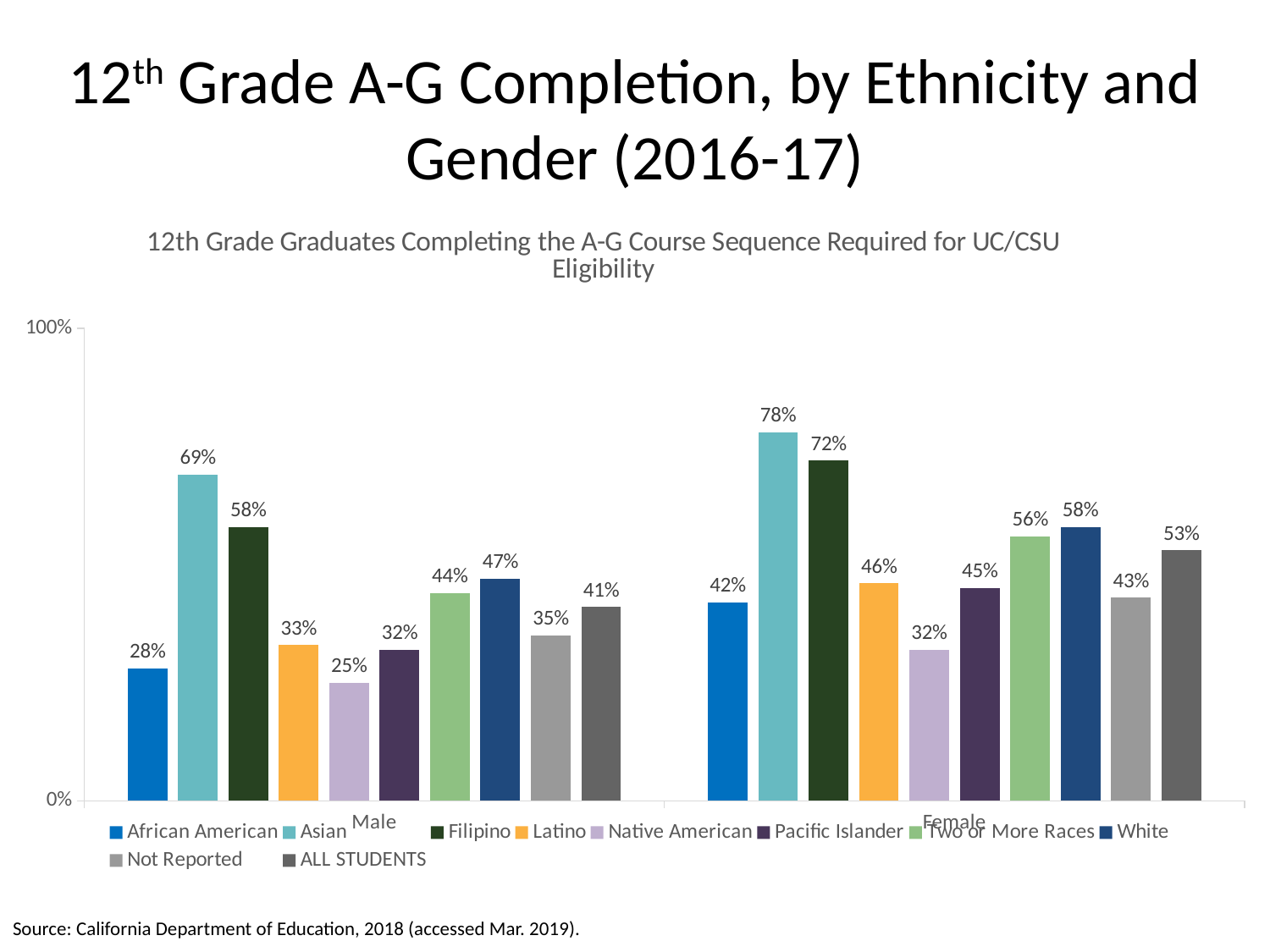
How many series does the legend list? 10 What is the value for ALL STUDENTS in the Male group? 41% What is the difference between the Filipino female rate and the Filipino male rate? 14% What kind of chart is shown on the slide? Bar chart What is the A-G completion rate for Asian male students? 69% Which ethnicity has the highest A-G completion rate among female students? Asian Which is larger, the White male rate or the Two or More Races male rate? White male rate What is the chart's title? 12th Grade Graduates Completing the A-G Course Sequence Required for UC/CSU Eligibility What is the difference between the Asian female rate and the Asian male rate? 9% How many gender groups are shown on the x axis? 2 What is the A-G completion rate for Latino female students? 46% Which ethnicity has the lowest A-G completion rate among male students? Native American